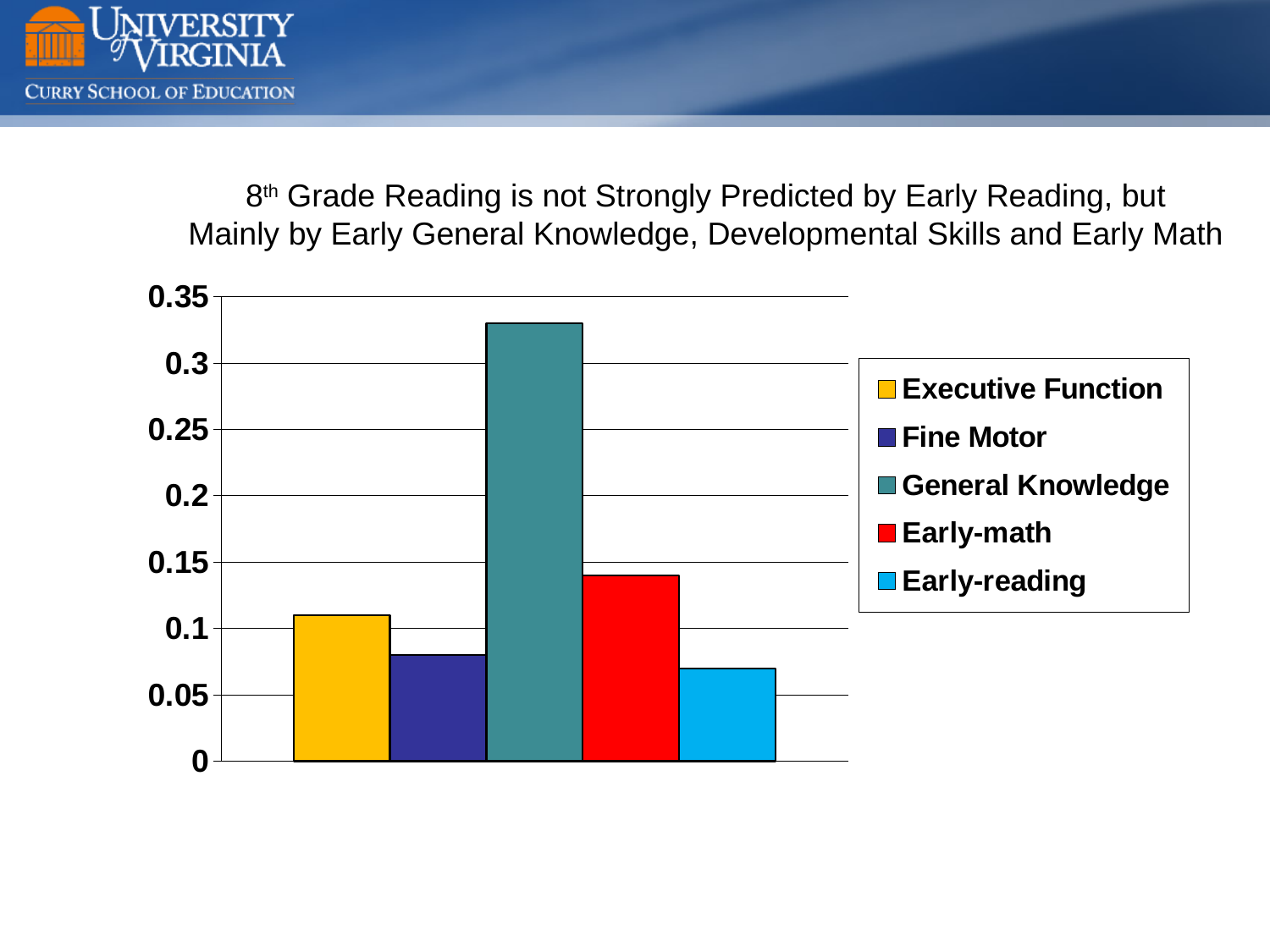
Is the value for General Knowledge greater or less than 0.3? greater What kind of chart is shown on the slide? bar chart What is the highest value shown on the vertical axis? 0.35 Which is larger, the value for General Knowledge or the value for Early-math? General Knowledge Is the value for Executive Function greater or less than 0.1? greater Which series has the highest bar? General Knowledge Which is larger, the value for Early-math or the value for Executive Function? Early-math How many bars are plotted in the chart? 5 How many series does the legend list? 5 Is the value for Early-reading greater or less than 0.05? greater